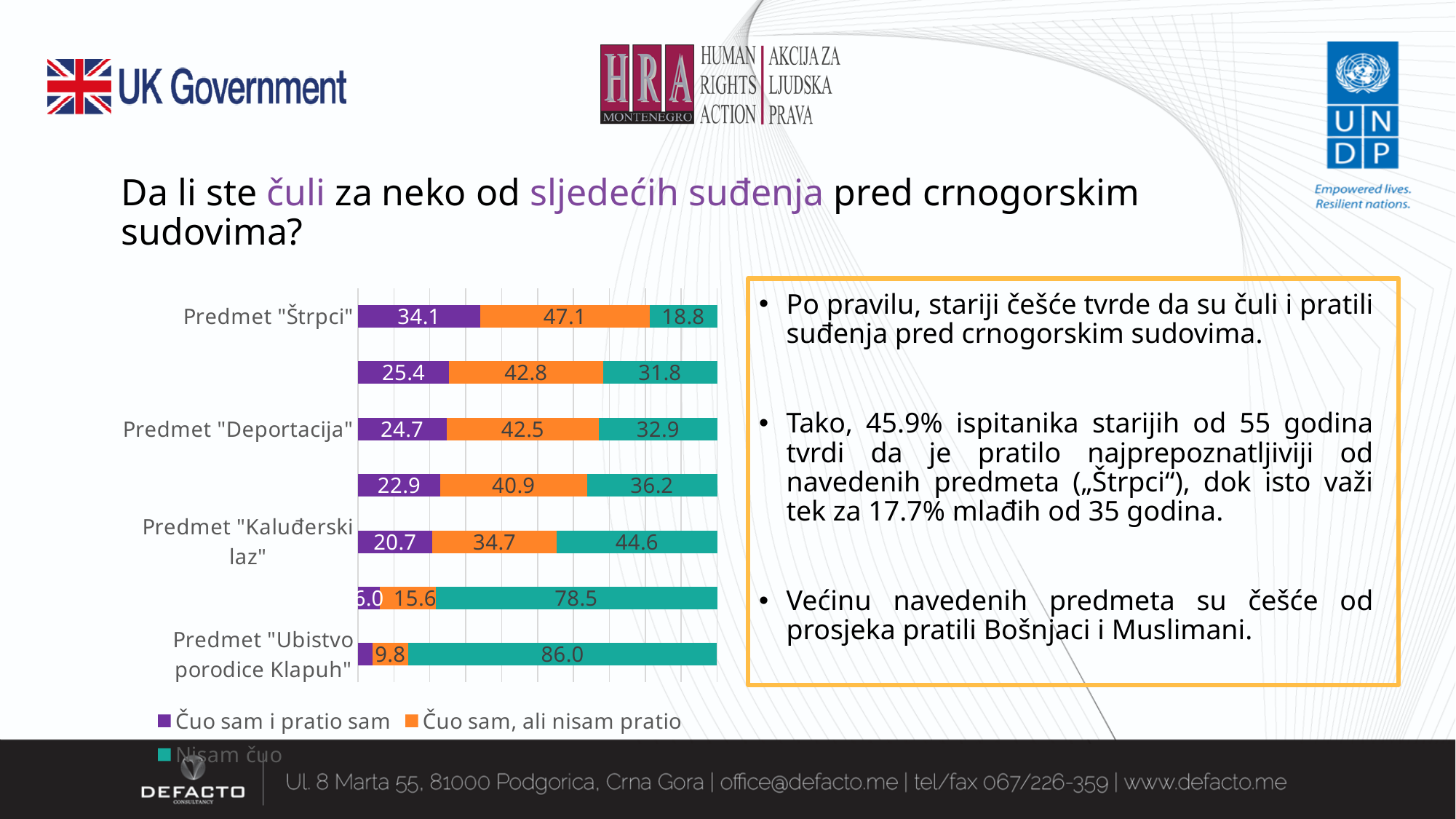
Which case has the highest "Čuo sam i pratio sam" value? Predmet "Štrpci" What is the value of "Nisam čuo" for Predmet "Kaluđerski laz"? 44.6 Which case has the highest "Nisam čuo" value? Predmet "Ubistvo porodice Klapuh" What is the value of "Čuo sam i pratio sam" for Predmet "Štrpci"? 34.1 How many series does the chart legend list? 3 For Predmet "Štrpci", what is the difference between "Čuo sam, ali nisam pratio" and "Čuo sam i pratio sam"? 13.0 How many bars are plotted in the chart? 7 For Predmet "Kaluđerski laz", which is larger: "Nisam čuo" or "Čuo sam, ali nisam pratio"? Nisam čuo What is the value of "Nisam čuo" for Predmet "Ubistvo porodice Klapuh"? 86.0 What is the value of "Čuo sam, ali nisam pratio" for Predmet "Deportacija"? 42.5 What kind of chart is shown on the slide? Stacked bar chart What is the value of "Nisam čuo" for Predmet "Štrpci"? 18.8